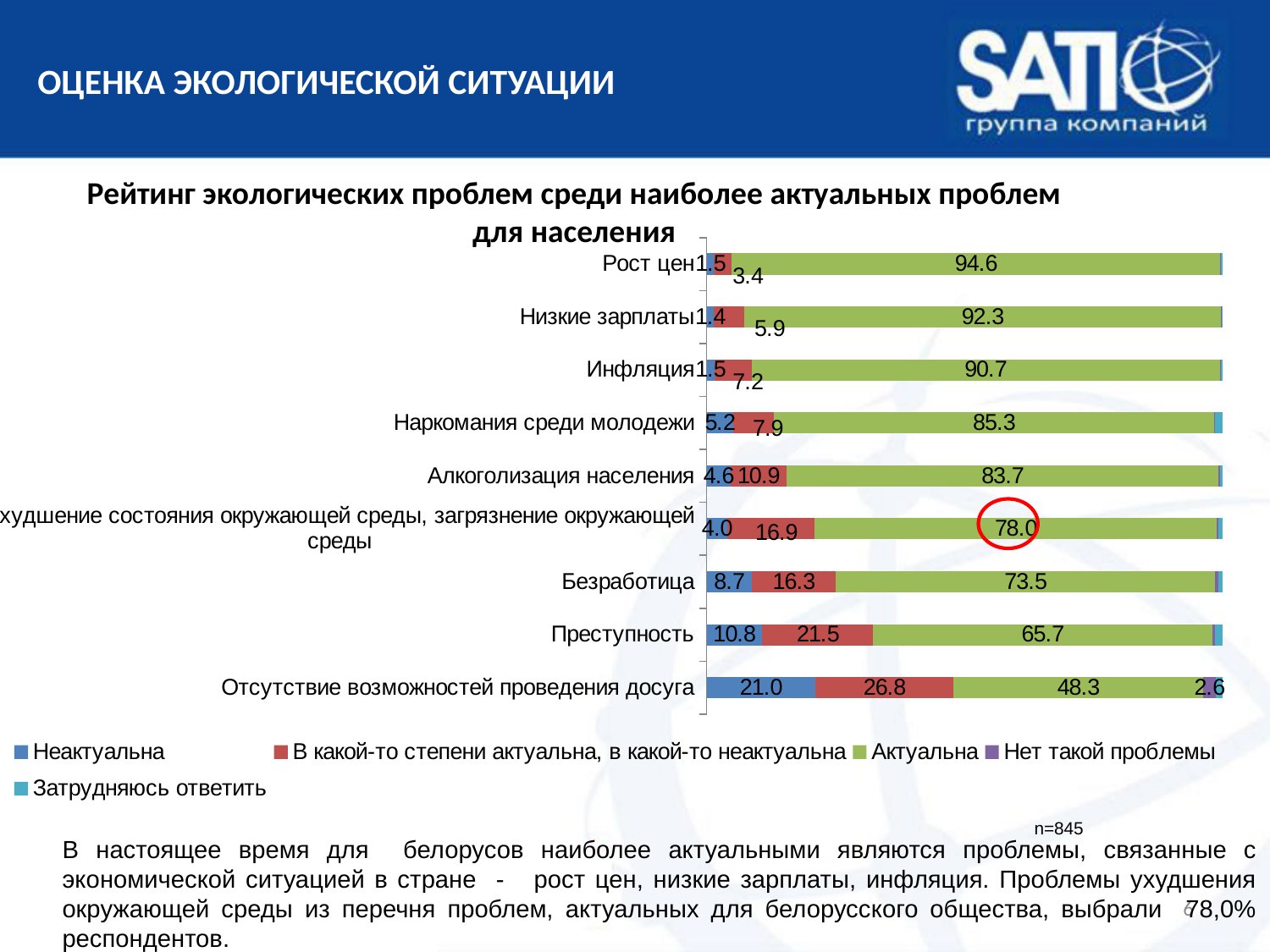
Which series is shown in green in the chart? Актуальна What is the "Актуальна" value for "Рост цен"? 94.6 What type of chart is shown on the slide? stacked bar chart How many series does the legend list? 5 What is the difference between the "Актуальна" values for "Низкие зарплаты" and "Безработица"? 18.8 How many categories (problems) are listed on the chart? 9 Which category has the highest "Актуальна" value? Рост цен Which has a larger "Неактуальна" value: "Безработица" or "Преступность"? Преступность What is the "В какой-то степени актуальна, в какой-то неактуальна" value for "Преступность"? 21.5 Which category has the lowest "Актуальна" value? Отсутствие возможностей проведения досуга What is the "Актуальна" value for "Ухудшение состояния окружающей среды, загрязнение окружающей среды"? 78.0 What is the "Неактуальна" value for "Отсутствие возможностей проведения досуга"? 21.0